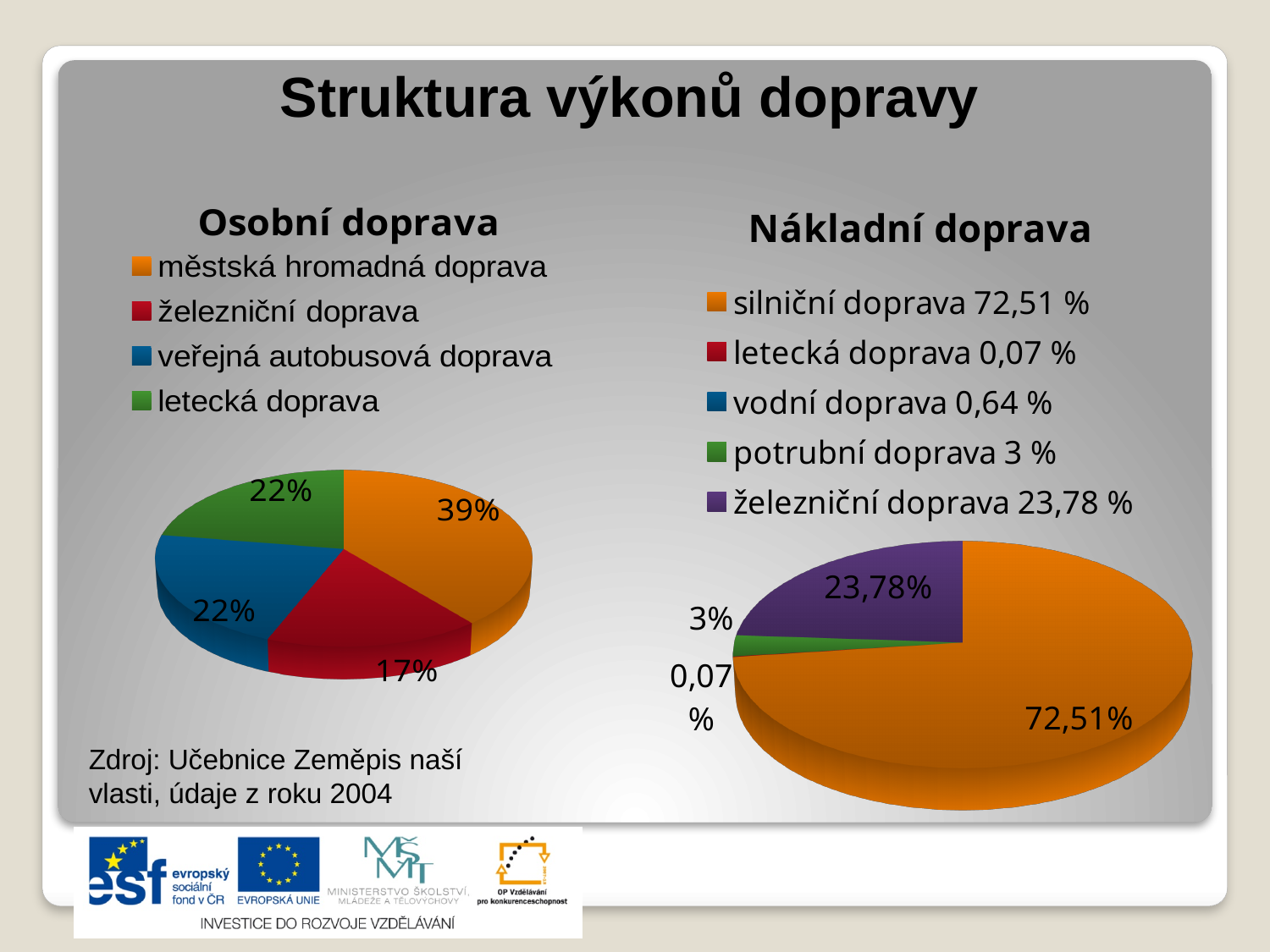
How many categories does the legend of the Osobní doprava chart list? 4 In the Osobní doprava chart, what share does železniční doprava have? 17% In the Osobní doprava chart, which category has the largest share? městská hromadná doprava In the Nákladní doprava chart, what share does silniční doprava have? 72,51 % In the Osobní doprava chart, what is the difference between the shares of městská hromadná doprava and železniční doprava? 22% What type of chart is used for Nákladní doprava? pie chart In the Nákladní doprava chart, which category has the smallest share? letecká doprava How many categories does the legend of the Nákladní doprava chart list? 5 In the Nákladní doprava chart, which is larger: potrubní doprava or vodní doprava? potrubní doprava In the Osobní doprava chart, what share does městská hromadná doprava have? 39% In the Osobní doprava chart, which category has the smallest share? železniční doprava In the Nákladní doprava chart, what share does železniční doprava have? 23,78 %